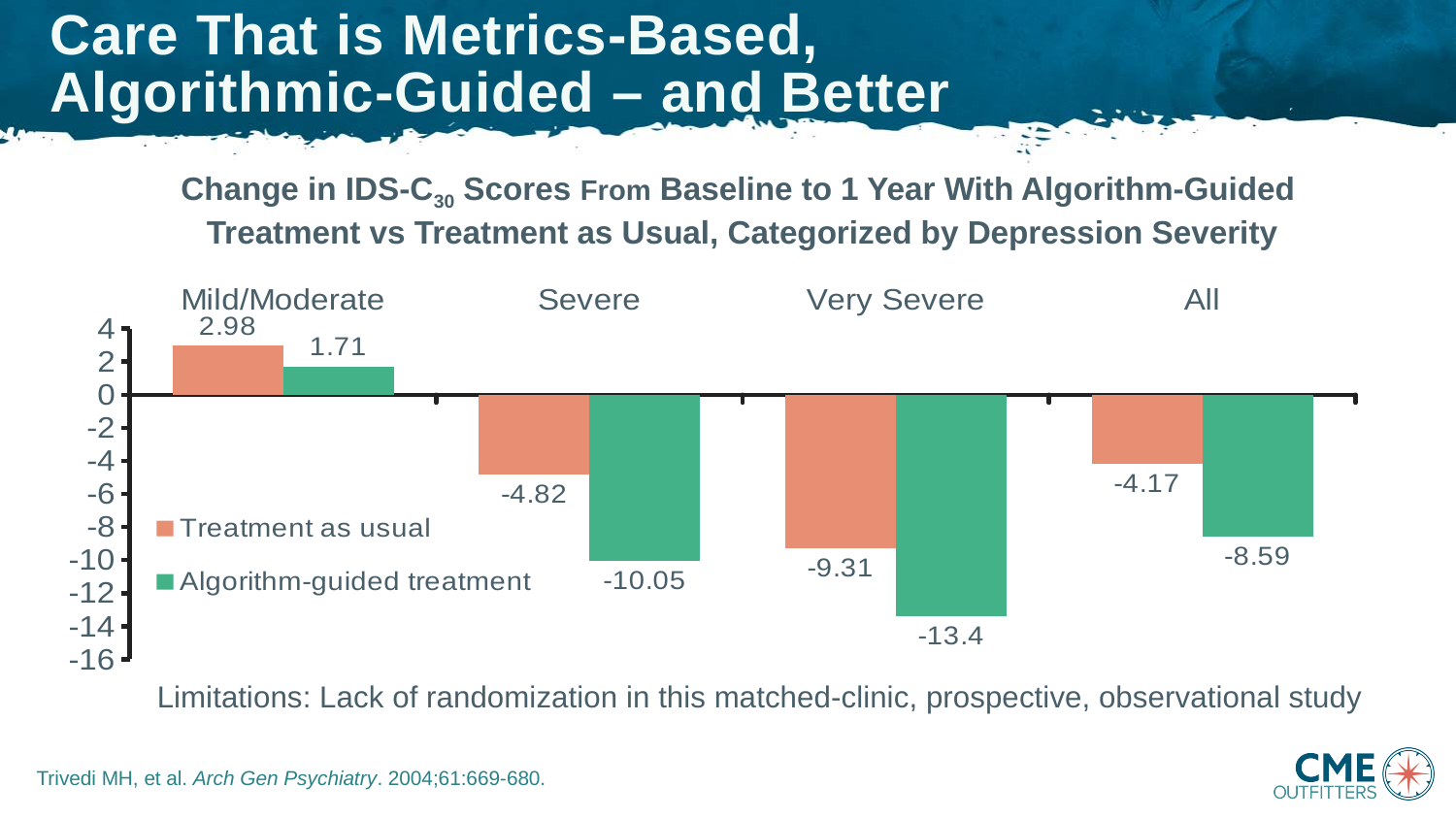
How many series does the legend list? 2 Which category has the highest value for Treatment as usual? Mild/Moderate What is the difference between the Treatment as usual and Algorithm-guided treatment values in the Severe category? 5.23 What is the value for Treatment as usual in the Mild/Moderate category? 2.98 Which category has the lowest value for Algorithm-guided treatment? Very Severe What kind of chart is shown on the slide? Bar chart What is the value for Algorithm-guided treatment in the Severe category? -10.05 How many categories are shown on the x axis? 4 Is the value for Algorithm-guided treatment in the Very Severe category greater or less than -12? less What is the value for Treatment as usual in the All category? -4.17 What is the value for Algorithm-guided treatment in the Very Severe category? -13.4 In the All category, which series has the larger value: Treatment as usual or Algorithm-guided treatment? Treatment as usual